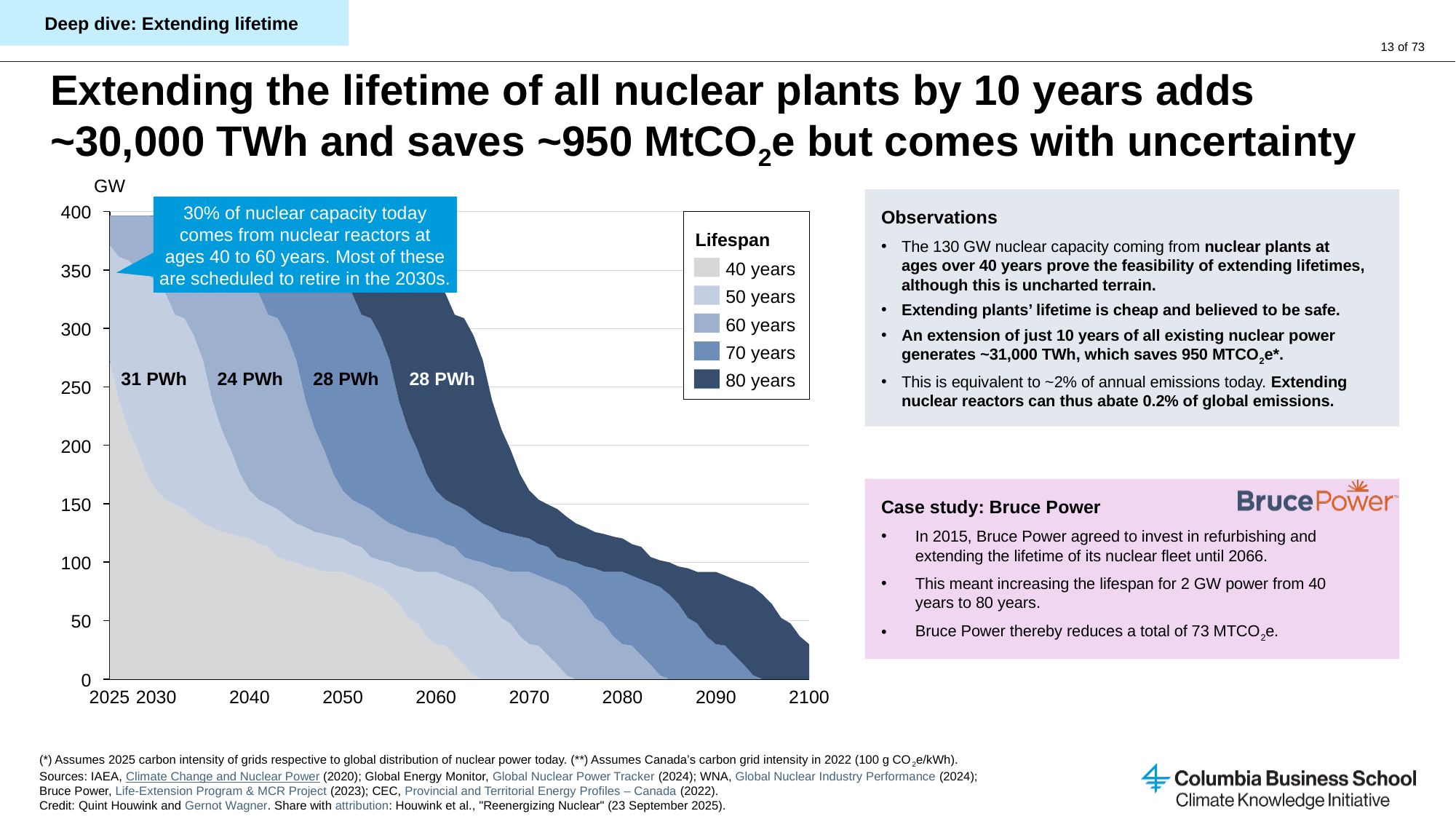
Which lifespan area carries the smallest PWh label? 60 years Does total nuclear capacity rise or fall along the x axis from 2025 to 2100? Fall What is the title of the chart's legend? Lifespan What PWh value is labelled on the 60 years lifespan area of the chart? 24 PWh What kind of chart is shown on the slide? Stacked area chart What unit is shown on the chart's vertical axis? GW How many lifespan series does the chart legend list? 5 Is the total capacity in 2025 greater or less than 350 GW? greater What PWh value is labelled on the 50 years lifespan area of the chart? 31 PWh Which lifespan area carries the largest PWh label? 50 years